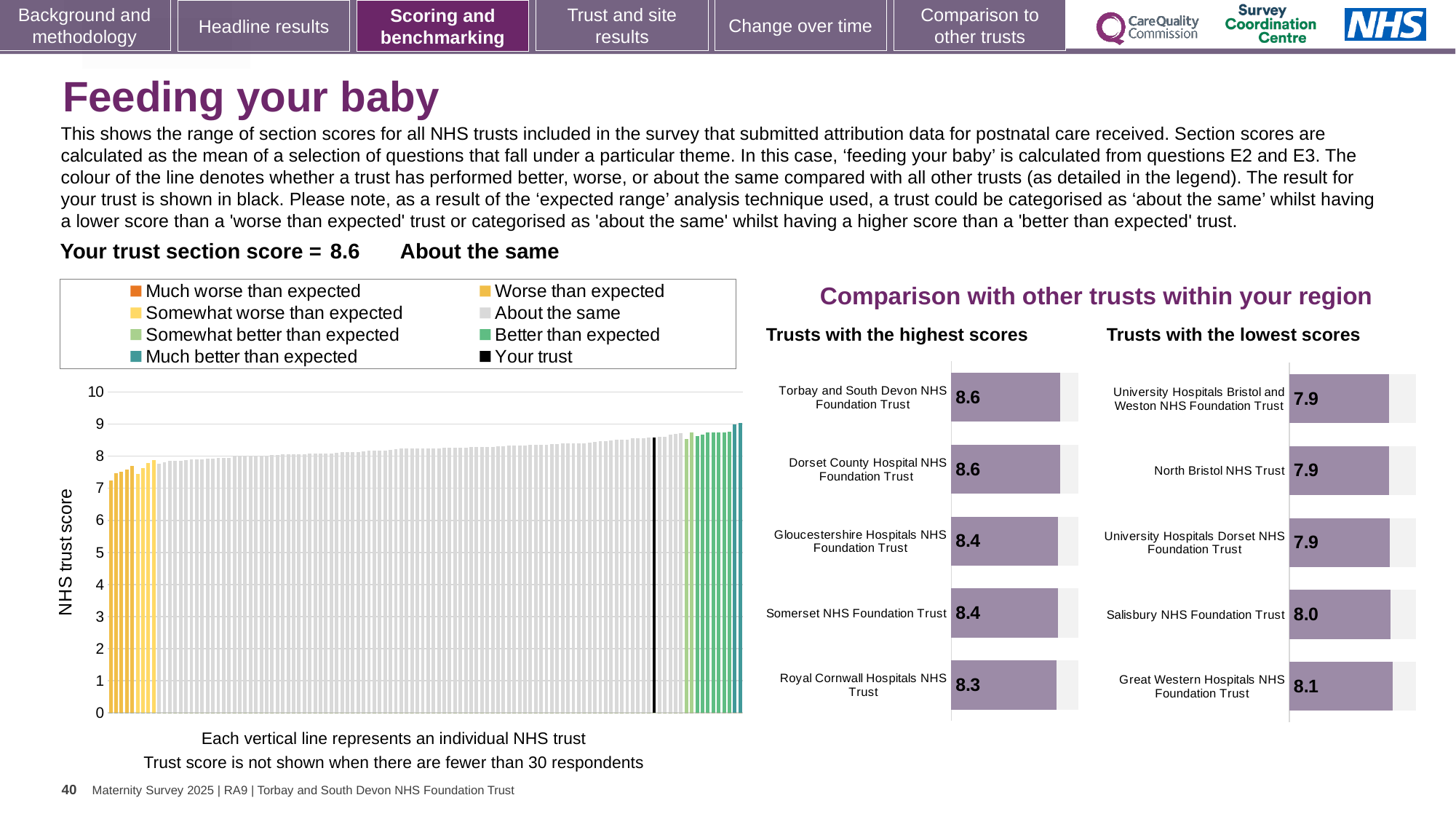
In the 'Trusts with the highest scores' chart, what is the difference between the scores of Torbay and South Devon NHS Foundation Trust and Royal Cornwall Hospitals NHS Trust? 0.3 In the 'Trusts with the highest scores' chart, which trust has the lowest score? Royal Cornwall Hospitals NHS Trust In the 'Trusts with the highest scores' chart, what is the score for Royal Cornwall Hospitals NHS Trust? 8.3 In the 'Trusts with the highest scores' chart, what is the score for Torbay and South Devon NHS Foundation Trust? 8.6 In the 'Trusts with the lowest scores' chart, which trust has the highest score? Great Western Hospitals NHS Foundation Trust In the 'Trusts with the lowest scores' chart, what is the difference between the scores of Great Western Hospitals NHS Foundation Trust and Salisbury NHS Foundation Trust? 0.1 In the 'Trusts with the lowest scores' chart, how many trusts are shown? 5 How many entries does the legend above the main NHS trust score chart list? 8 In the main NHS trust score chart on the left, do the bar values rise or fall from left to right? rise In the main NHS trust score chart on the left, is the value for the black 'Your trust' bar greater or less than 8? greater In the 'Trusts with the lowest scores' chart, what is the score for Salisbury NHS Foundation Trust? 8.0 In the 'Trusts with the highest scores' chart, which has the higher score: Gloucestershire Hospitals NHS Foundation Trust or Royal Cornwall Hospitals NHS Trust? Gloucestershire Hospitals NHS Foundation Trust